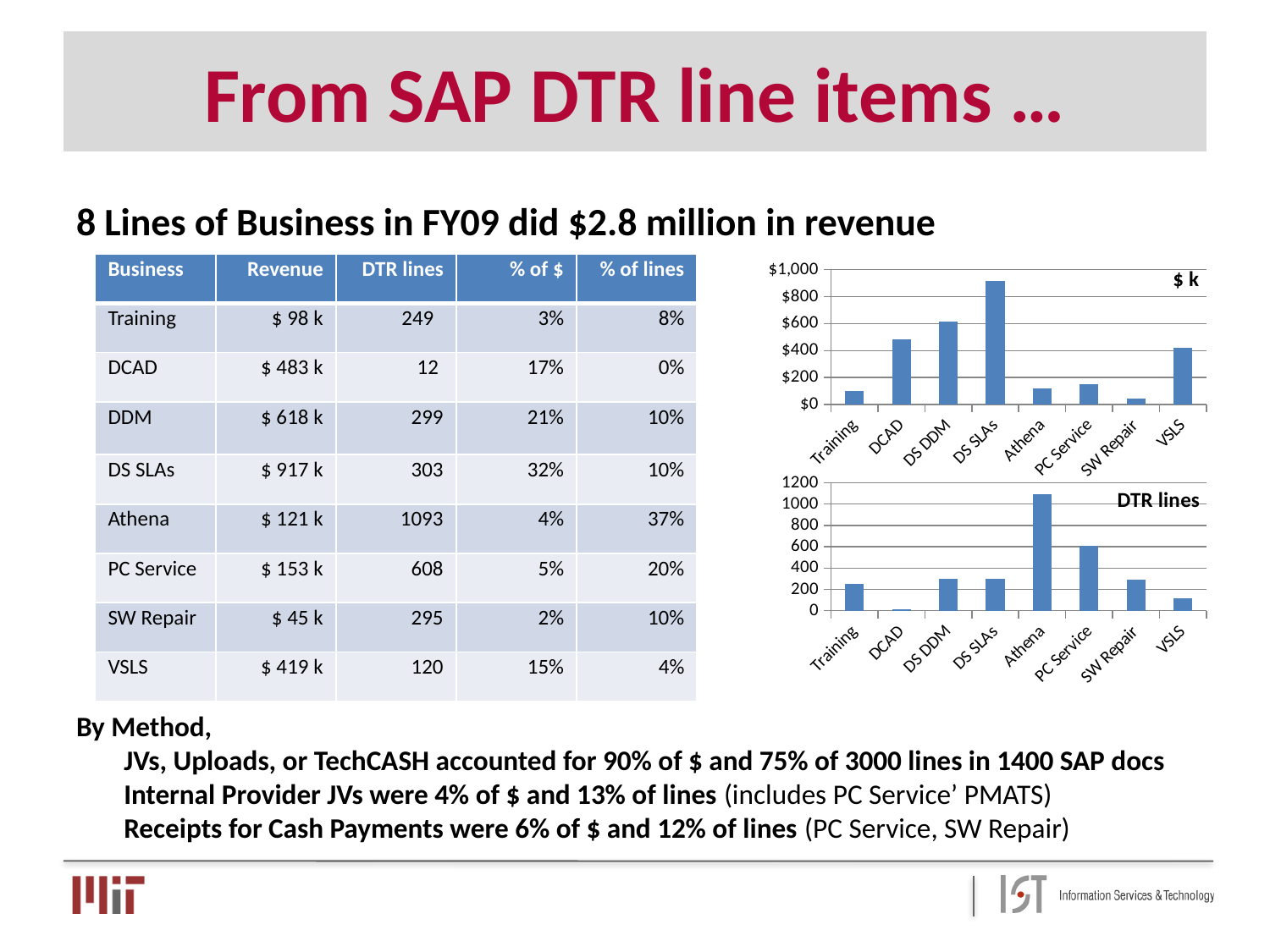
In the "$ k" chart, is the value for DS SLAs greater or less than $800? greater In the "$ k" chart, which is larger, the bar for DS DDM or the bar for DCAD? DS DDM What is the title shown on the upper chart on the slide? $ k What kind of chart is the "$ k" chart on the slide? bar chart In the "DTR lines" chart, is the value for PC Service greater or less than 400? greater In the "DTR lines" chart, which business has the highest bar? Athena In the "$ k" chart, which business has the highest bar? DS SLAs In the "DTR lines" chart, which is larger, the bar for Training or the bar for VSLS? Training How many businesses are plotted in the "DTR lines" chart? 8 In the "$ k" chart, is the value for Athena greater or less than $200? less In the "DTR lines" chart, which business has the lowest bar? DCAD In the "$ k" chart, which business has the lowest bar? SW Repair